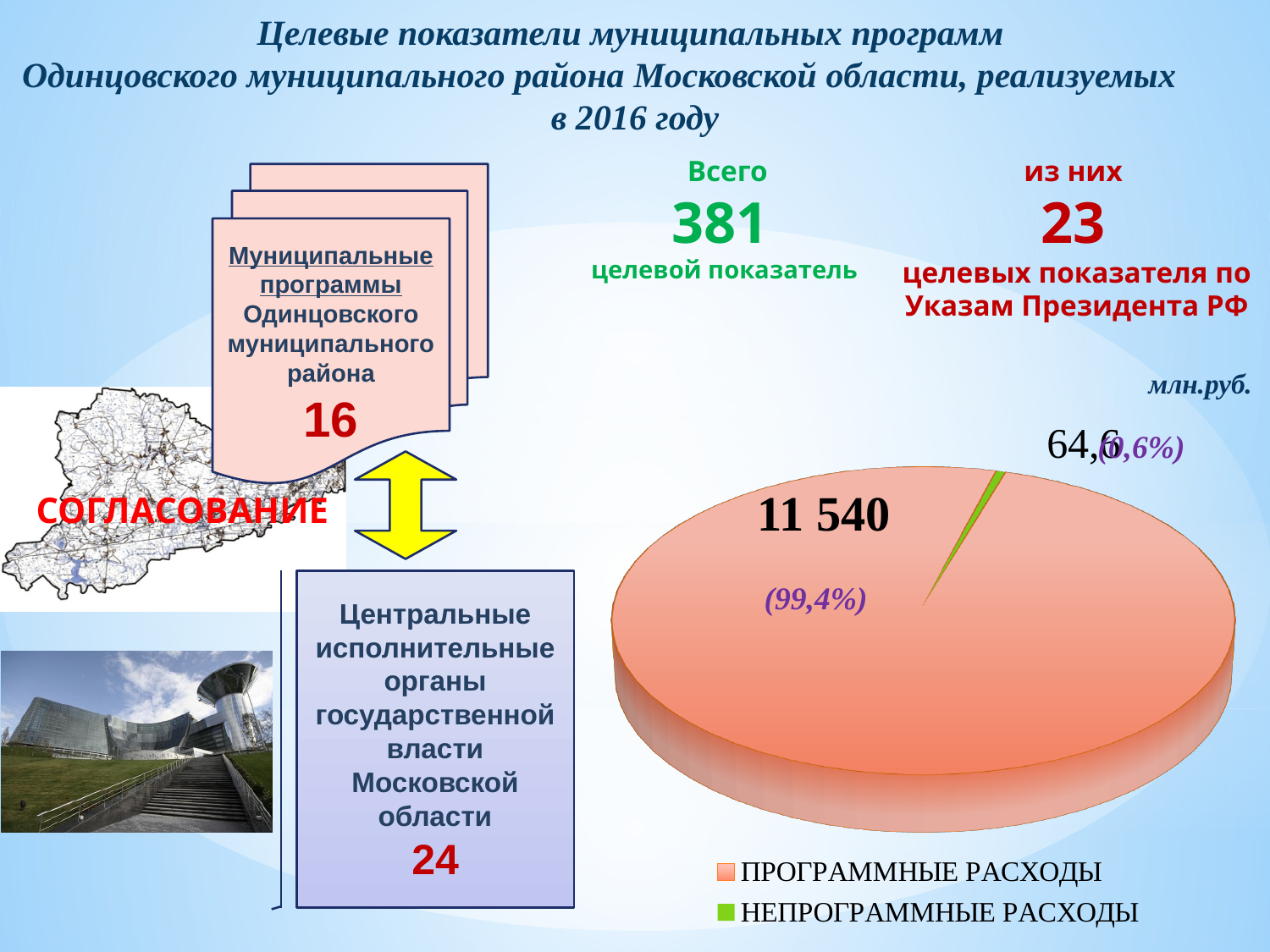
Which is larger in the pie chart, ПРОГРАММНЫЕ РАСХОДЫ or НЕПРОГРАММНЫЕ РАСХОДЫ? ПРОГРАММНЫЕ РАСХОДЫ What colour is the НЕПРОГРАММНЫЕ РАСХОДЫ slice in the pie chart? green How many entries does the pie chart legend list? 2 Which slice of the pie chart is the smallest? НЕПРОГРАММНЫЕ РАСХОДЫ What is the value for ПРОГРАММНЫЕ РАСХОДЫ in the pie chart? 11 540 What share of the pie does НЕПРОГРАММНЫЕ РАСХОДЫ represent? 0,6% What unit is indicated for the values in the pie chart? млн.руб. What is the value for НЕПРОГРАММНЫЕ РАСХОДЫ in the pie chart? 64,6 Which slice of the pie chart is the largest? ПРОГРАММНЫЕ РАСХОДЫ What share of the pie does ПРОГРАММНЫЕ РАСХОДЫ represent? 99,4% What kind of chart is shown on the slide? pie chart How many slices does the pie chart have? 2